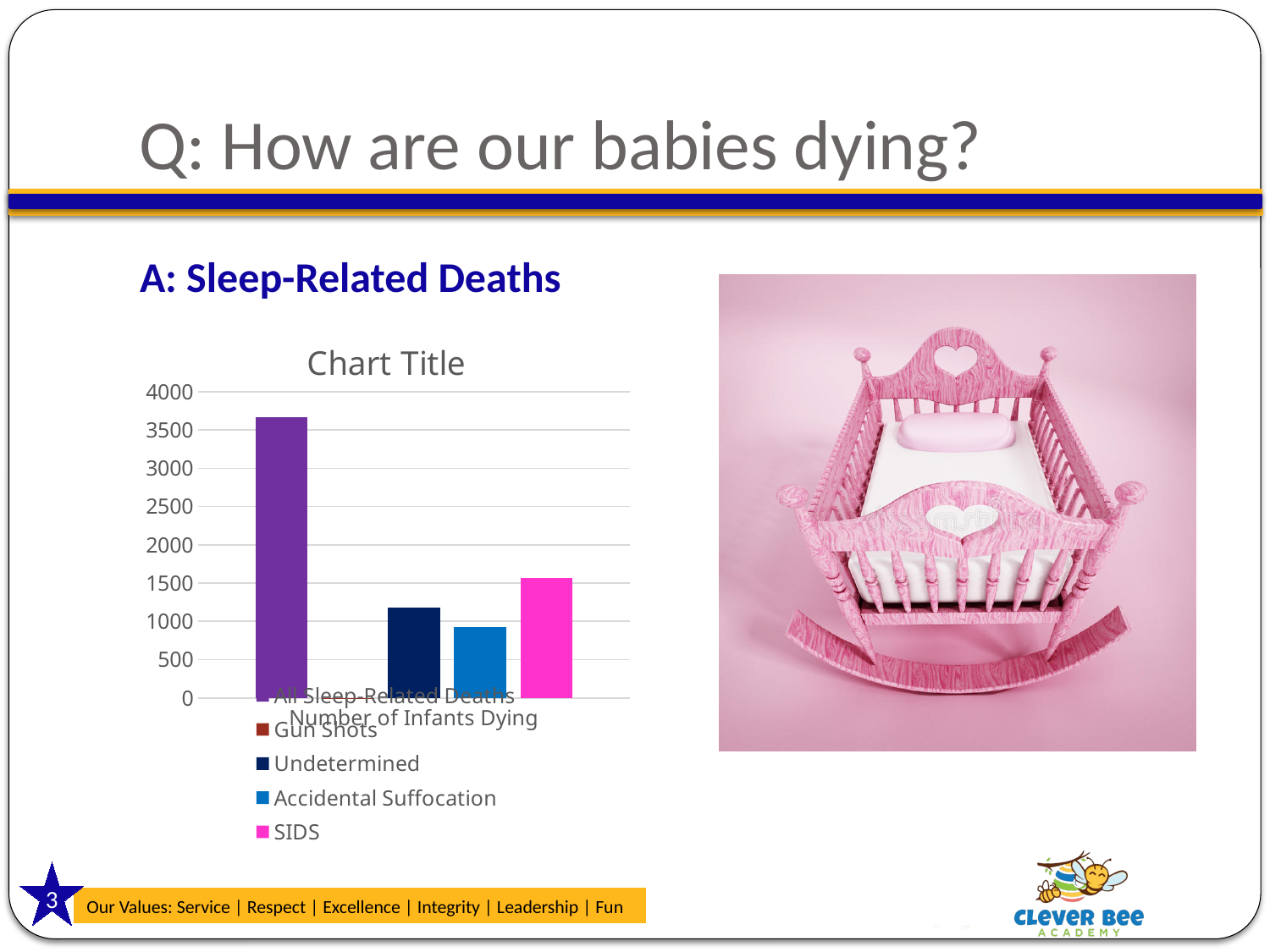
What is the title shown above the chart? Chart Title Is the value for All Sleep-Related Deaths greater or less than 3500? greater Which series has the highest bar in the chart? All Sleep-Related Deaths Is the value for SIDS greater or less than 2000? less How many series does the chart's legend list? 5 Is the value for Undetermined greater or less than 1000? greater What colour is the SIDS bar in the chart? pink What kind of chart is shown on the slide? bar chart Which is larger, the value for SIDS or the value for Undetermined? SIDS What is the category label shown on the x axis of the chart? Number of Infants Dying Which is larger, the value for Undetermined or the value for Accidental Suffocation? Undetermined